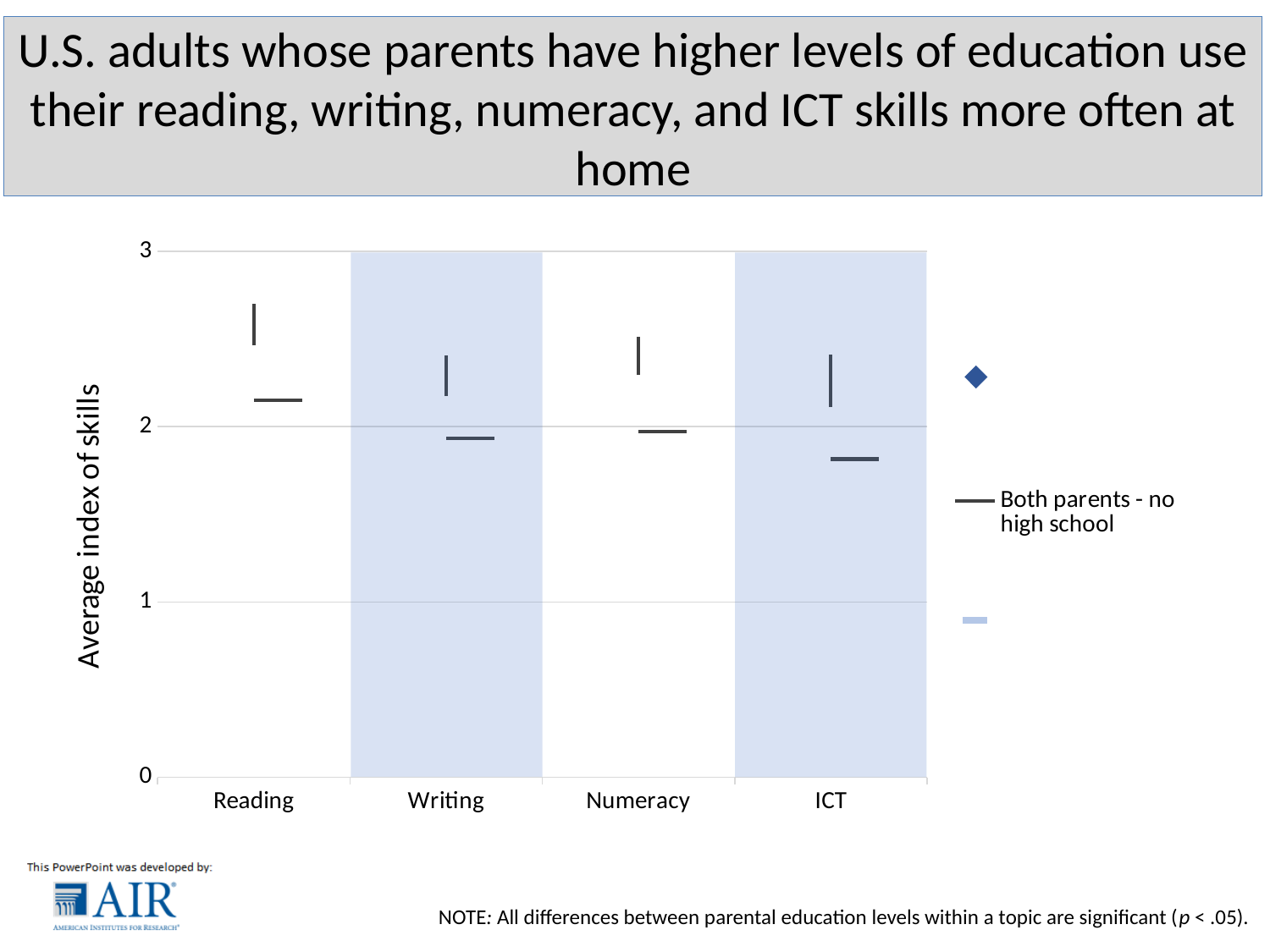
Is the 'Both parents - no high school' value for Writing greater or less than 2? less How many skill categories are shown along the x axis of the chart? 4 For 'Both parents - no high school', which is larger: the value for Numeracy or the value for ICT? Numeracy Is the 'Both parents - no high school' value for ICT greater or less than 2? less What is the label on the vertical axis of the chart? Average index of skills What is the highest value shown on the vertical axis of the chart? 3 Which category has the lowest value for 'Both parents - no high school'? ICT Is the 'Both parents - no high school' value for Reading greater or less than 2? greater For 'Both parents - no high school', which is larger: the value for Reading or the value for ICT? Reading Which category has the highest value for 'Both parents - no high school'? Reading